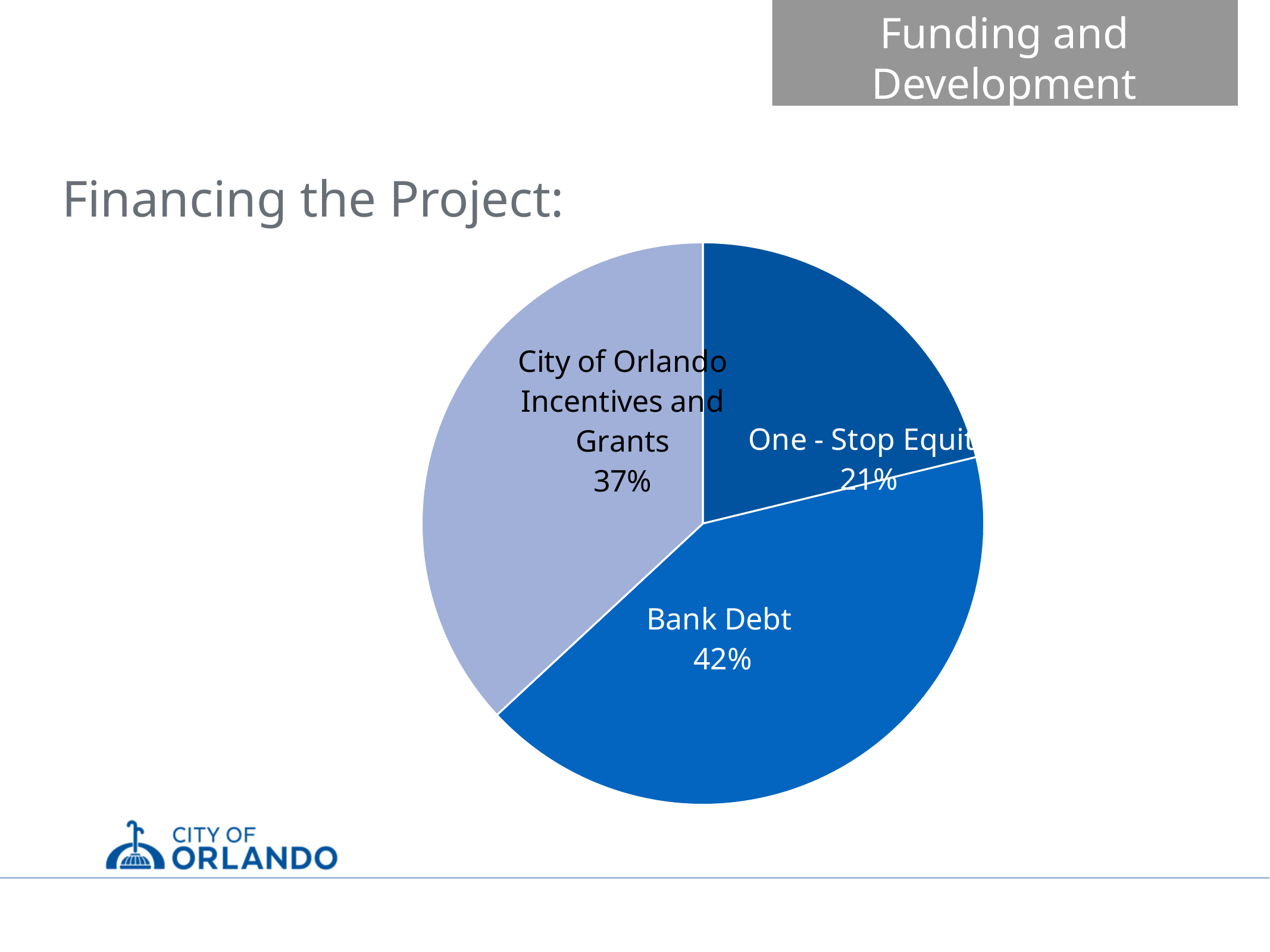
Which slice of the pie is drawn in the lightest colour? City of Orlando Incentives and Grants Which funding source makes up the smallest share of the pie? One-Stop Equity Which funding source makes up the largest share of the pie? Bank Debt How many slices does the pie chart have? 3 Which is larger: the Bank Debt share or the City of Orlando Incentives and Grants share? Bank Debt What kind of chart is shown on the slide? pie chart What percentage of the project financing comes from City of Orlando Incentives and Grants? 37% What percentage of the project financing comes from One-Stop Equity? 21% What is the heading above the pie chart? Financing the Project: How many percentage points larger is the City of Orlando Incentives and Grants share than the One-Stop Equity share? 16 percentage points How many percentage points larger is the Bank Debt share than the City of Orlando Incentives and Grants share? 5 percentage points What percentage of the project financing comes from Bank Debt? 42%